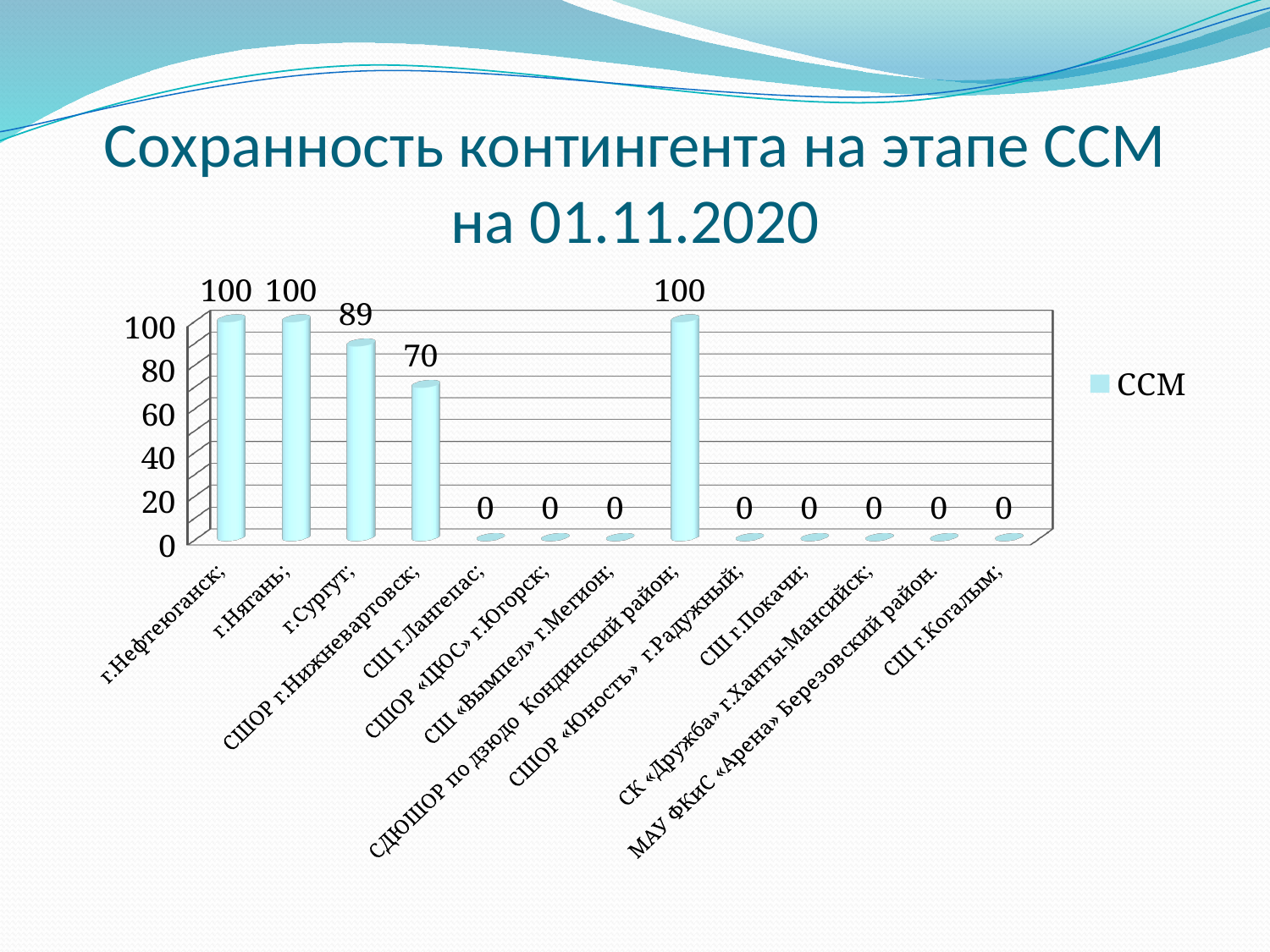
How many categories have a value of 0? 8 What kind of chart is shown on the slide? bar chart How many series does the legend list? 1 What is the title of the chart on the slide? Сохранность контингента на этапе ССМ на 01.11.2020 What is the value for СДЮШОР по дзюдо Кондинский район? 100 Which is larger, the value for г.Сургут or the value for СШОР г.Нижневартовск? г.Сургут What is the value for СШ г.Лангепас? 0 What is the difference between the values for г.Сургут and СШОР г.Нижневартовск? 19 How many categories are shown on the x axis? 13 What is the value for г.Сургут? 89 What is the value for г.Нягань? 100 What is the value for СШОР г.Нижневартовск? 70